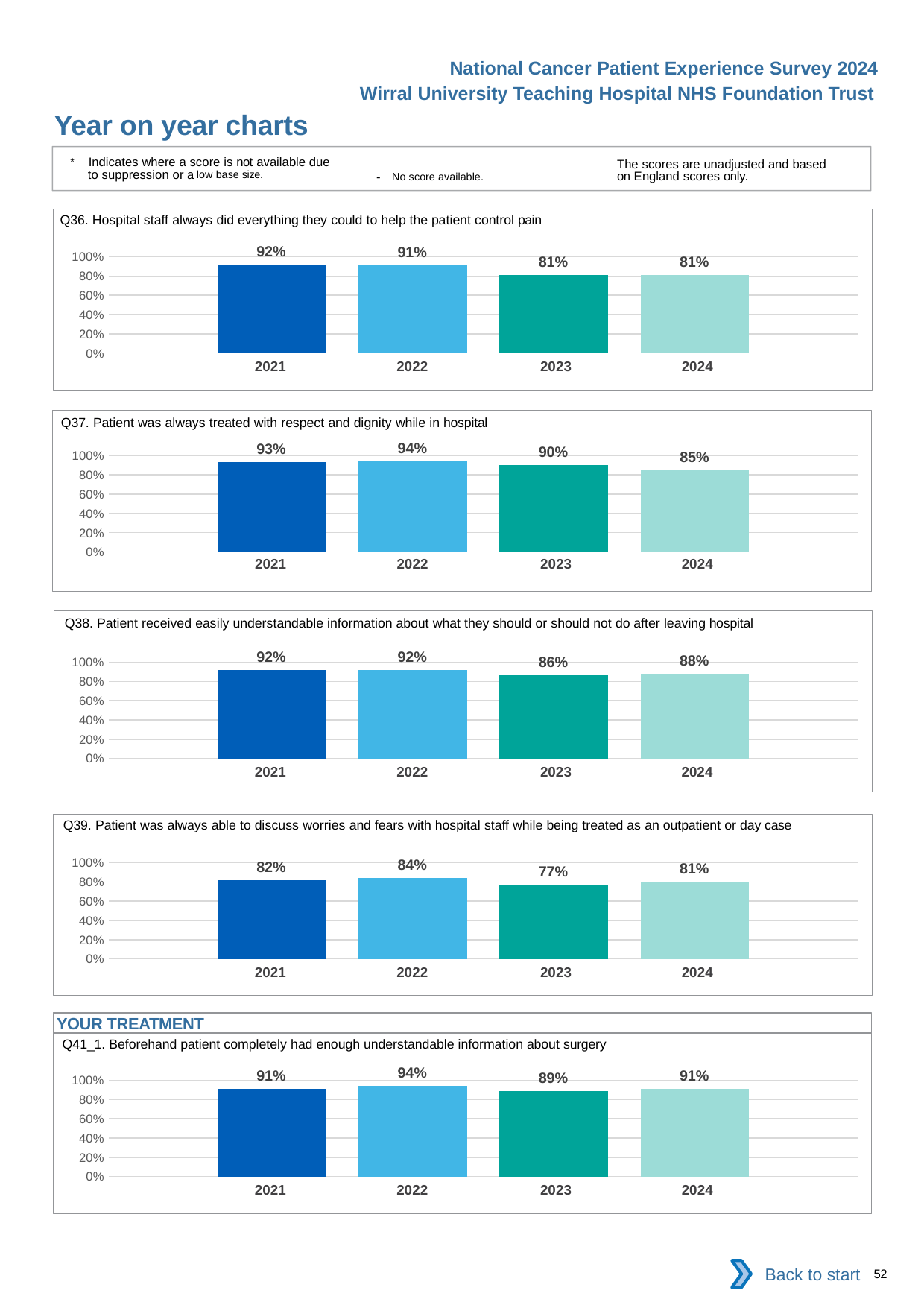
In the Q38 chart (Patient received easily understandable information about what they should or should not do after leaving hospital), which year has the lowest value? 2023 In the Q41_1 chart (Beforehand patient completely had enough understandable information about surgery), what is the value for 2023? 89% In the Q37 chart (Patient was always treated with respect and dignity while in hospital), what is the value for 2024? 85% In the Q39 chart (Patient was always able to discuss worries and fears with hospital staff while being treated as an outpatient or day case), which is larger, the 2022 value or the 2024 value? 2022 In the Q39 chart (Patient was always able to discuss worries and fears with hospital staff while being treated as an outpatient or day case), what is the value for 2023? 77% In the Q37 chart (Patient was always treated with respect and dignity while in hospital), which year has the highest value? 2022 In the Q36 chart (Hospital staff always did everything they could to help the patient control pain), do the values generally rise or fall from 2021 to 2024? Fall In the Q38 chart (Patient received easily understandable information about what they should or should not do after leaving hospital), what is the difference between the 2021 and 2024 values? 4% In the Q41_1 chart (Beforehand patient completely had enough understandable information about surgery), what is the difference between the 2022 and 2023 values? 5% In the Q36 chart (Hospital staff always did everything they could to help the patient control pain), what is the value for 2021? 92% What kind of chart is the Q37 chart (Patient was always treated with respect and dignity while in hospital)? Bar chart How many years are shown on the x axis of the Q36 chart (Hospital staff always did everything they could to help the patient control pain)? 4